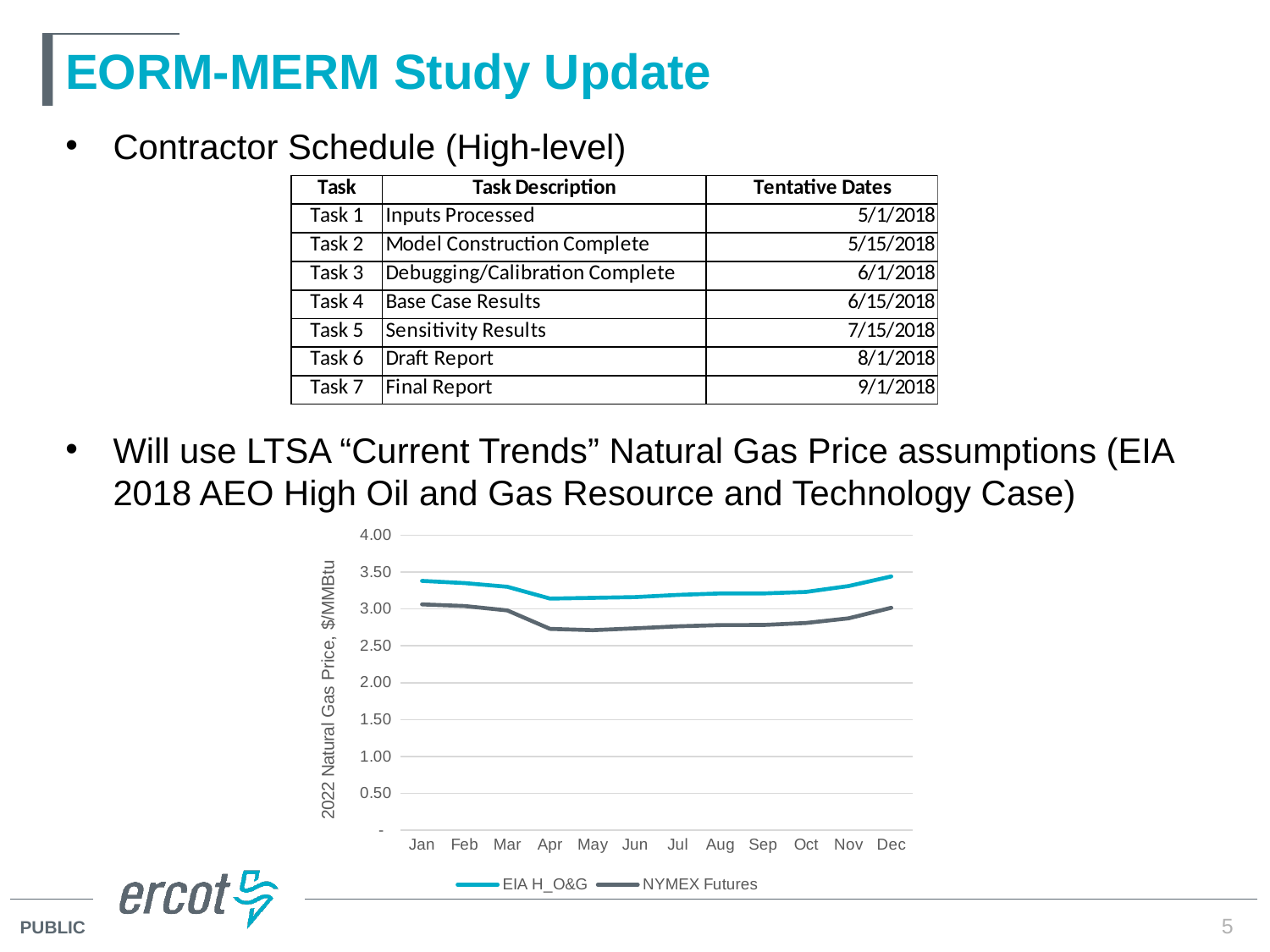
What kind of chart is shown on the slide? Line chart Does the EIA H_O&G line rise or fall from April to December? rise Does the NYMEX Futures line rise or fall from January to May? fall Is the EIA H_O&G value for April greater or less than 3.50? less Which series has the lower value in January? NYMEX Futures Is the EIA H_O&G value for January greater or less than 3.00? greater What is the label on the chart's vertical axis? 2022 Natural Gas Price, $/MMBtu Is the NYMEX Futures value for January greater or less than 2.50? greater Which series is higher in July, EIA H_O&G or NYMEX Futures? EIA H_O&G How many months are plotted along the x axis of the chart? 12 How many series does the chart's legend list? 2